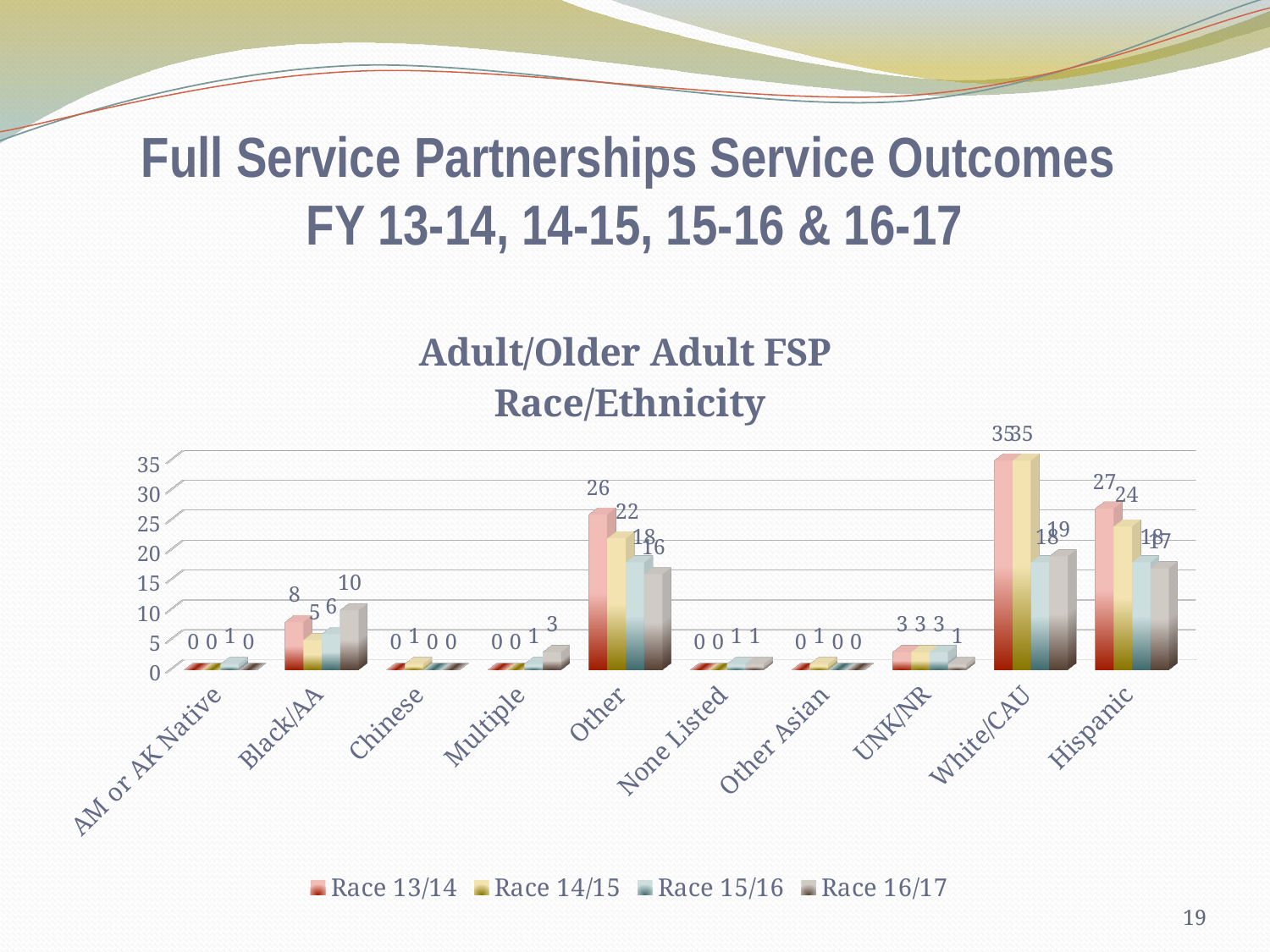
How many series does the legend list? 4 Which is larger, the Race 13/14 value for Black/AA or the Race 13/14 value for Hispanic? Hispanic What kind of chart is shown on the slide? bar chart Which category has the highest Race 16/17 value? White/CAU What is the Race 16/17 value for Black/AA? 10 For the Other category, do the values rise or fall from Race 13/14 to Race 16/17? fall What is the difference between the Race 13/14 and Race 14/15 values for the Other category? 4 What is the Race 14/15 value for White/CAU? 35 What is the Race 13/14 value for the Other category? 26 How many race/ethnicity categories are shown on the x axis? 10 Is the Race 16/17 value for the Other category greater or less than 20? less Which category has the highest Race 13/14 value? White/CAU